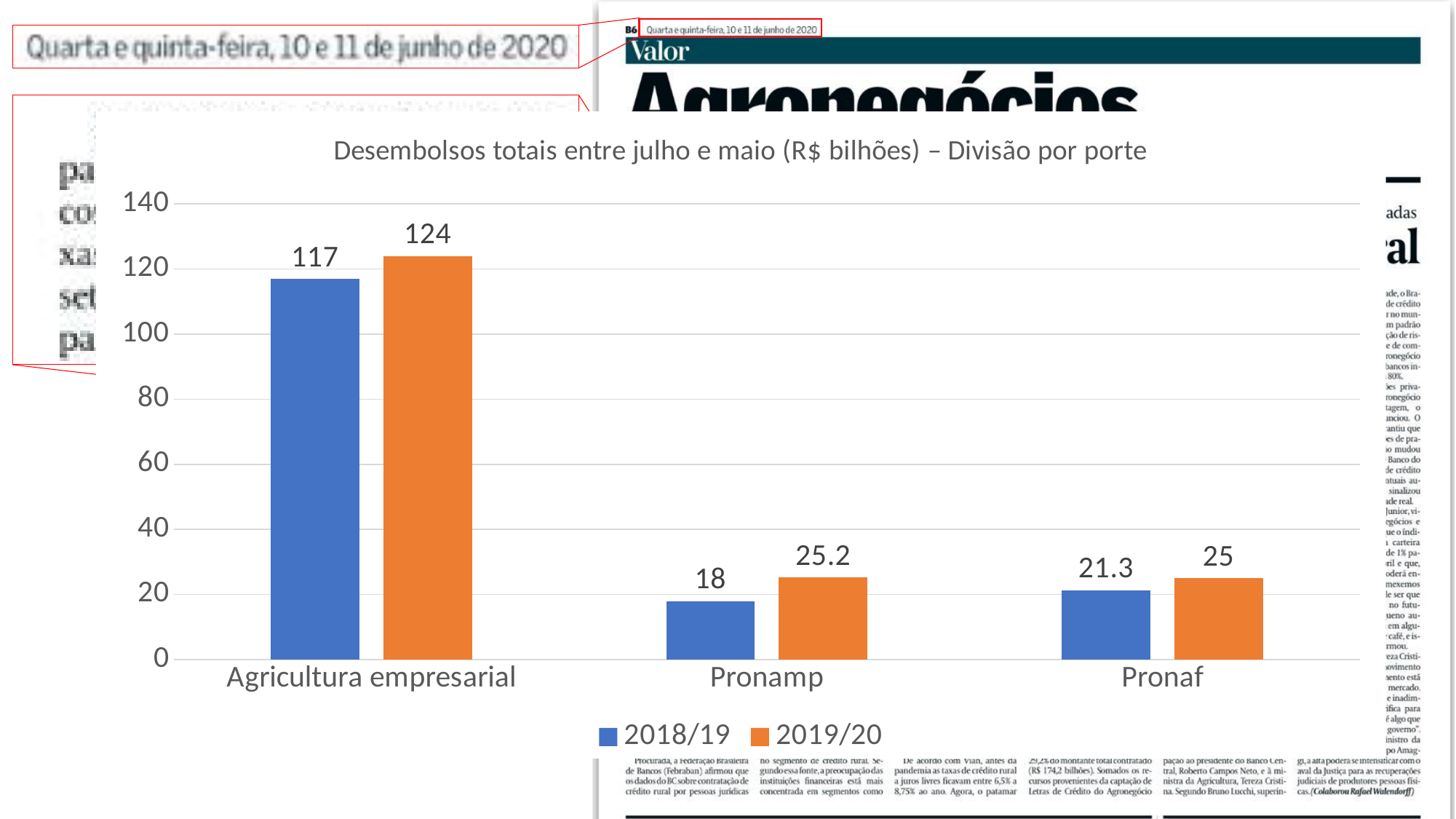
Which category has the highest value in the 2018/19 series? Agricultura empresarial What is the value for Pronamp in the 2018/19 series? 18 What is the difference between the 2019/20 and 2018/19 values for Pronamp? 7.2 What is the title of the chart? Desembolsos totais entre julho e maio (R$ bilhões) – Divisão por porte How many series does the legend list? 2 What is the value for Agricultura empresarial in the 2019/20 series? 124 What is the difference between the 2019/20 and 2018/19 values for Agricultura empresarial? 7 What kind of chart is shown on the slide? Bar chart Which is larger: the 2018/19 value for Pronaf or the 2018/19 value for Pronamp? Pronaf How many categories are shown on the x axis? 3 What is the value for Pronaf in the 2019/20 series? 25 Which category has the lowest value in the 2019/20 series? Pronaf